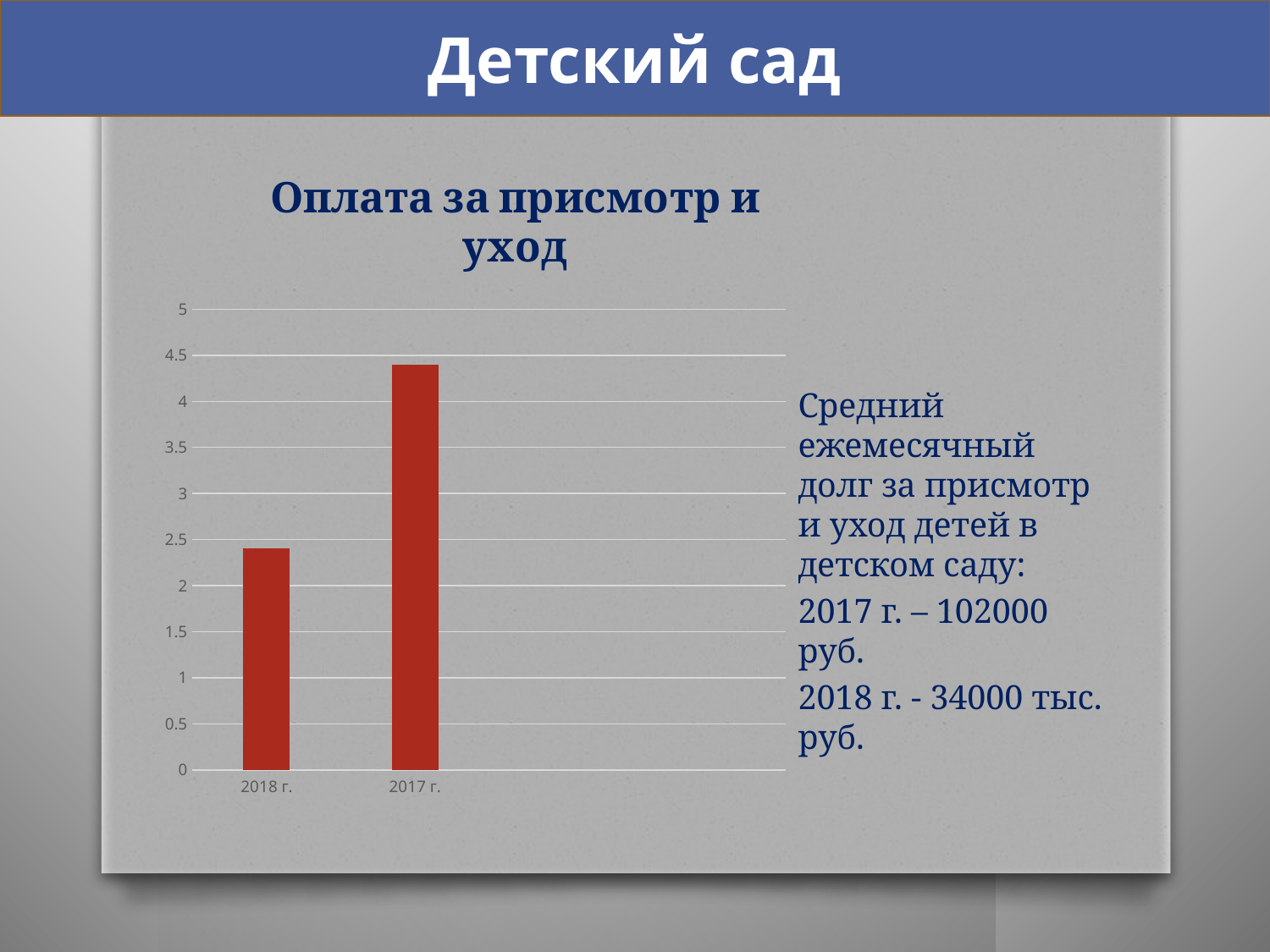
What colour are the bars in the chart? red Is the value for 2017 г. greater or less than 4? greater Do the bar values rise or fall moving from left to right along the x axis? rise Which category has the lowest bar in the chart? 2018 г. Which is larger, the value for 2018 г. or the value for 2017 г.? 2017 г. How many categories are shown on the x axis of the chart? 2 Is the value for 2018 г. greater or less than 3? less What kind of chart is shown on the slide? bar chart Which category has the highest bar in the chart? 2017 г. What is the title of the chart? Оплата за присмотр и уход Is the value for 2018 г. greater or less than 2? greater